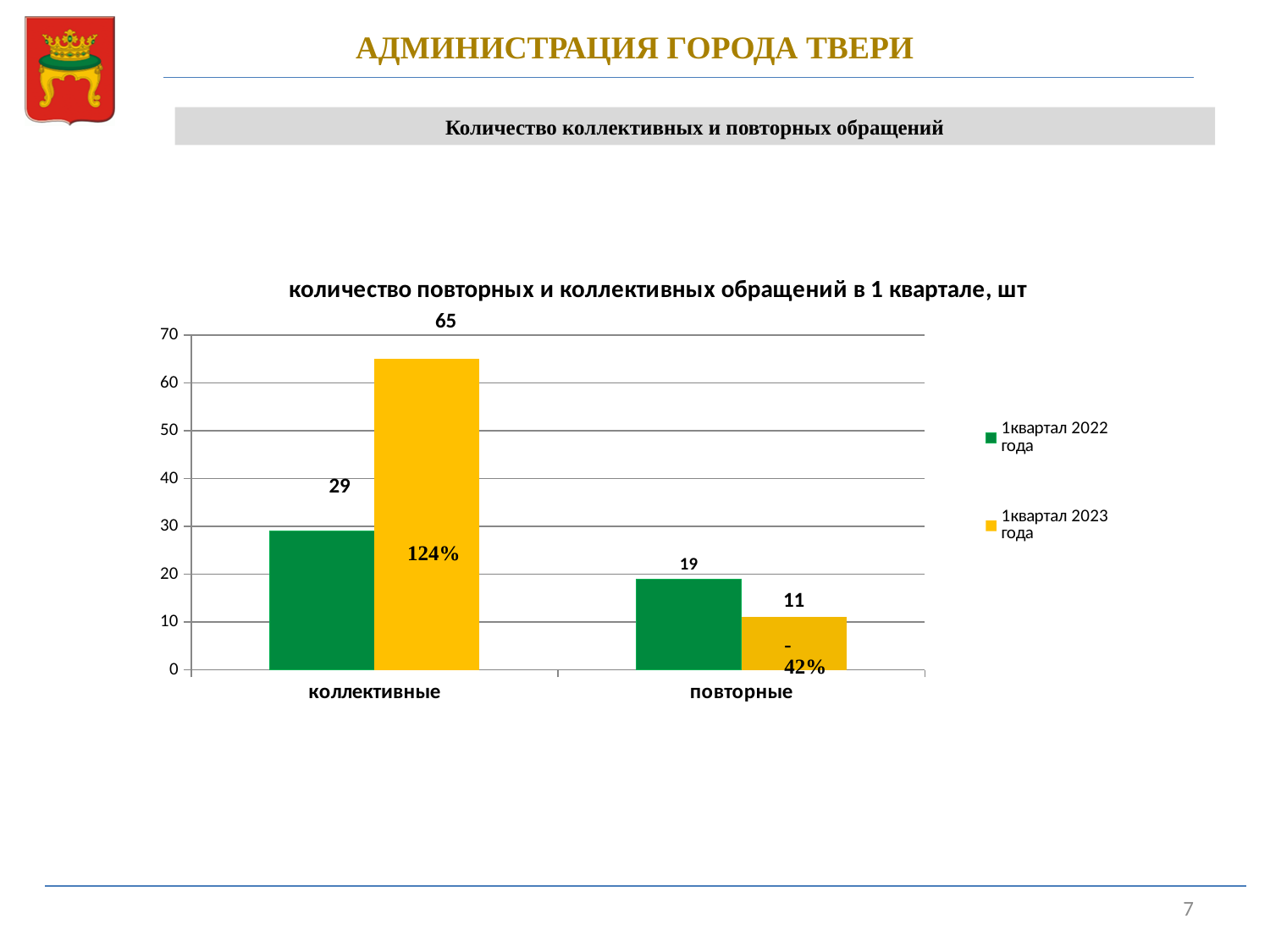
What is the difference between the 1квартал 2022 года and 1квартал 2023 года values for повторные? 8 Which category has the highest value in 1квартал 2023 года? коллективные How many categories are shown on the x axis? 2 What is the value for повторные in 1квартал 2022 года? 19 Which category has the lowest value in 1квартал 2022 года? повторные What is the difference between the 1квартал 2023 года and 1квартал 2022 года values for коллективные? 36 What is the value for коллективные in 1квартал 2022 года? 29 How many series does the legend list? 2 What is the value for коллективные in 1квартал 2023 года? 65 What is the value for повторные in 1квартал 2023 года? 11 What kind of chart is shown on the slide? bar chart Which is larger for повторные: 1квартал 2022 года or 1квартал 2023 года? 1квартал 2022 года